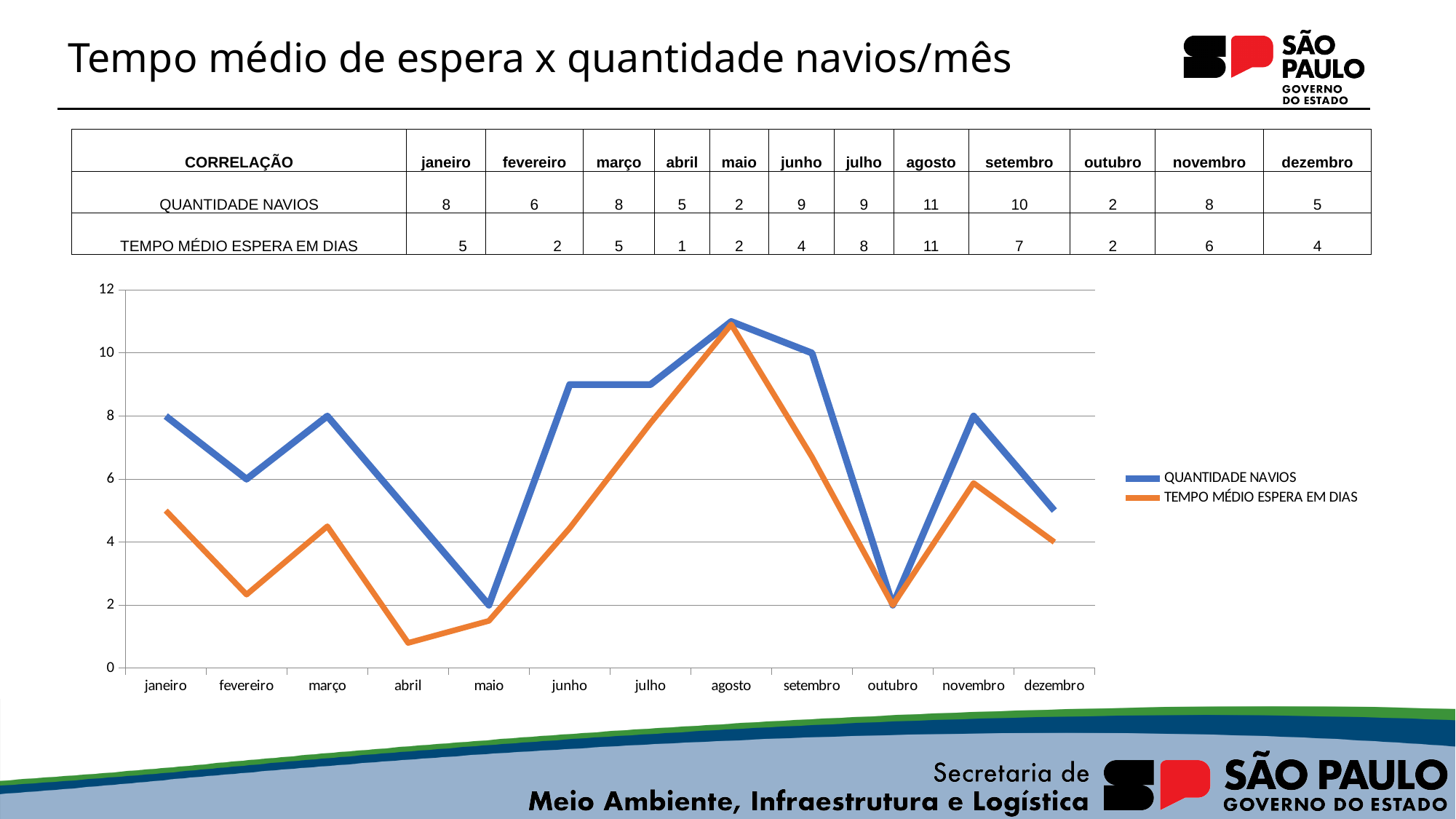
How many series does the chart legend list? 2 What is the value of TEMPO MÉDIO ESPERA EM DIAS for julho? 8 What kind of chart is shown on the slide? line chart Does QUANTIDADE NAVIOS rise or fall from setembro to outubro? fall What is the value of QUANTIDADE NAVIOS for agosto? 11 Which colour is the QUANTIDADE NAVIOS line in the chart? blue What is the value of QUANTIDADE NAVIOS for maio? 2 How many months are plotted along the x axis of the chart? 12 Which is larger in setembro, QUANTIDADE NAVIOS or TEMPO MÉDIO ESPERA EM DIAS? QUANTIDADE NAVIOS In which month is QUANTIDADE NAVIOS highest? agosto In which month is TEMPO MÉDIO ESPERA EM DIAS lowest? abril What is the difference between QUANTIDADE NAVIOS and TEMPO MÉDIO ESPERA EM DIAS in junho? 5